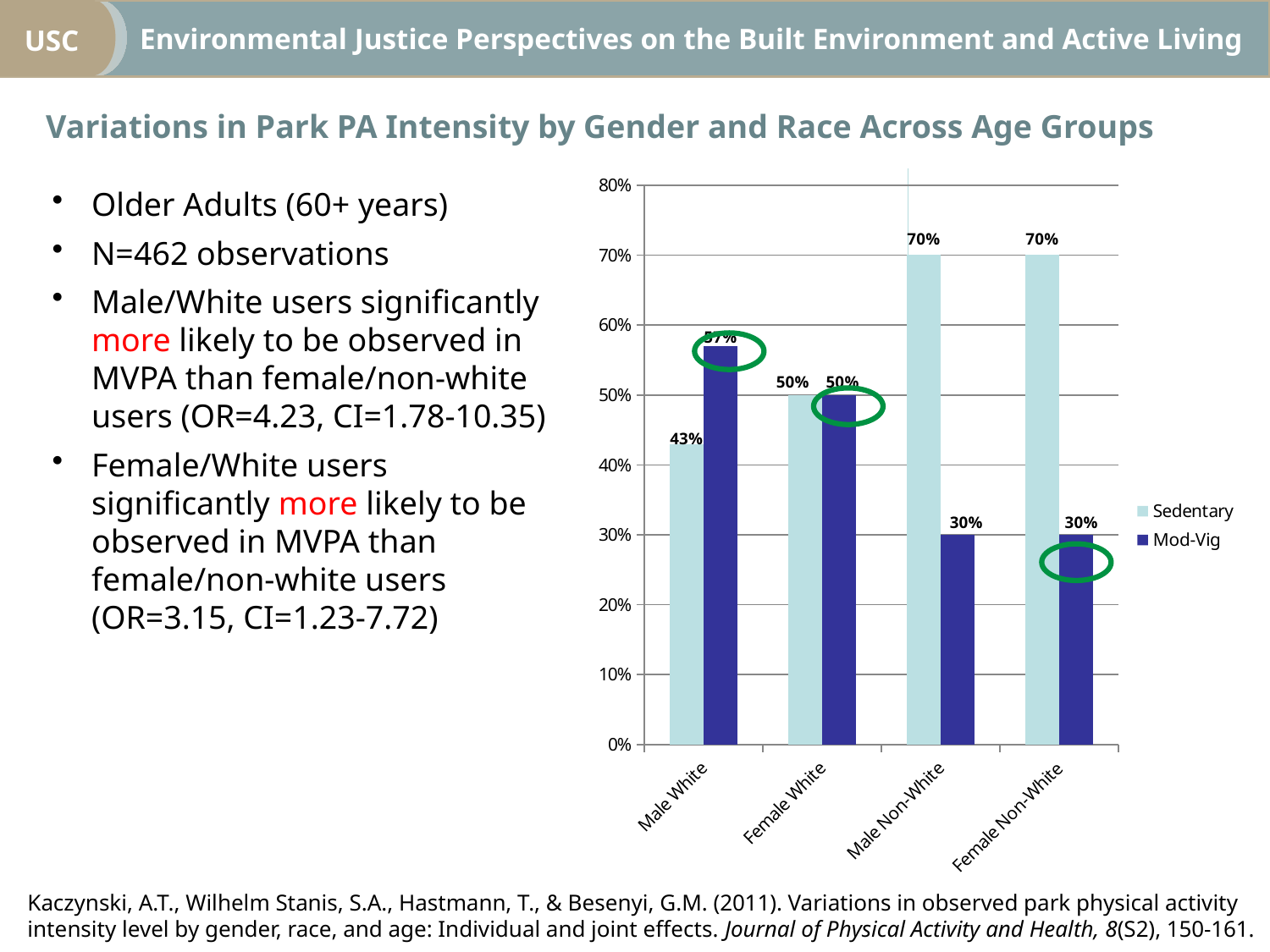
What is the Sedentary value for Male White? 43% What type of chart is shown on the slide? bar chart Which category has the highest Mod-Vig value? Male White What is the Mod-Vig value for Male White? 57% How many categories are shown on the x axis of the chart? 4 What is the Mod-Vig value for Female Non-White? 30% Which is larger for Male White, the Sedentary value or the Mod-Vig value? Mod-Vig What is the Sedentary value for Male Non-White? 70% How many series does the chart's legend list? 2 Which category has the lowest Mod-Vig value? Male Non-White and Female Non-White (both 30%) What is the difference between the Sedentary and Mod-Vig values for Male Non-White? 40% Which series is shown in dark blue in the legend? Mod-Vig